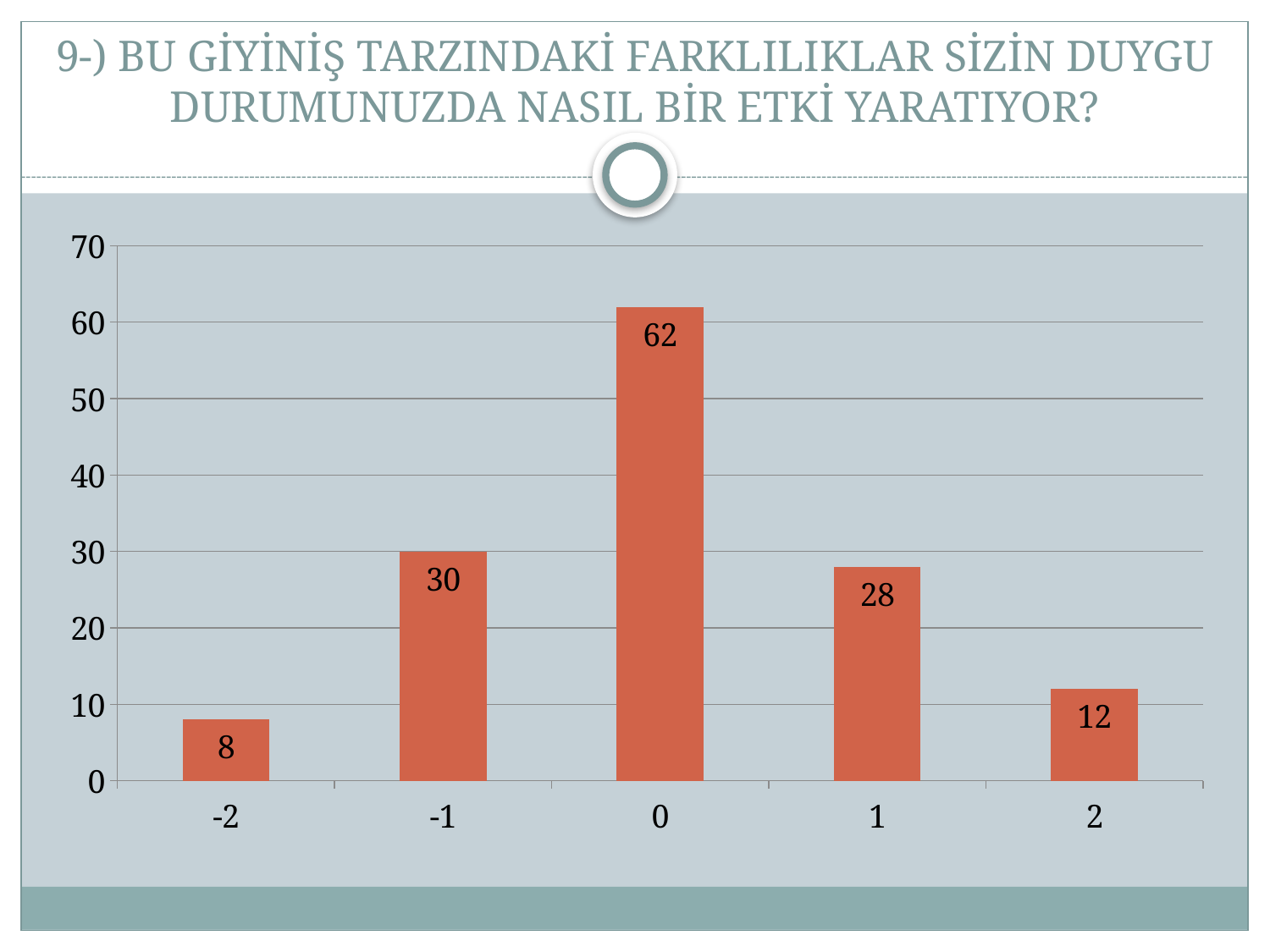
Which category has the lowest value? -2 What is the highest value shown on the y axis? 70 What is the value for category 2? 12 What is the difference between the values for 0 and 1? 34 Is the value for category 1 greater or less than 30? less What is the difference between the values for -1 and -2? 22 What is the value for category 0? 62 What is the value for category -1? 30 How many categories are shown on the x axis? 5 Which is larger, the value for -1 or the value for 1? -1 Which category has the highest value? 0 What kind of chart is shown on the slide? bar chart